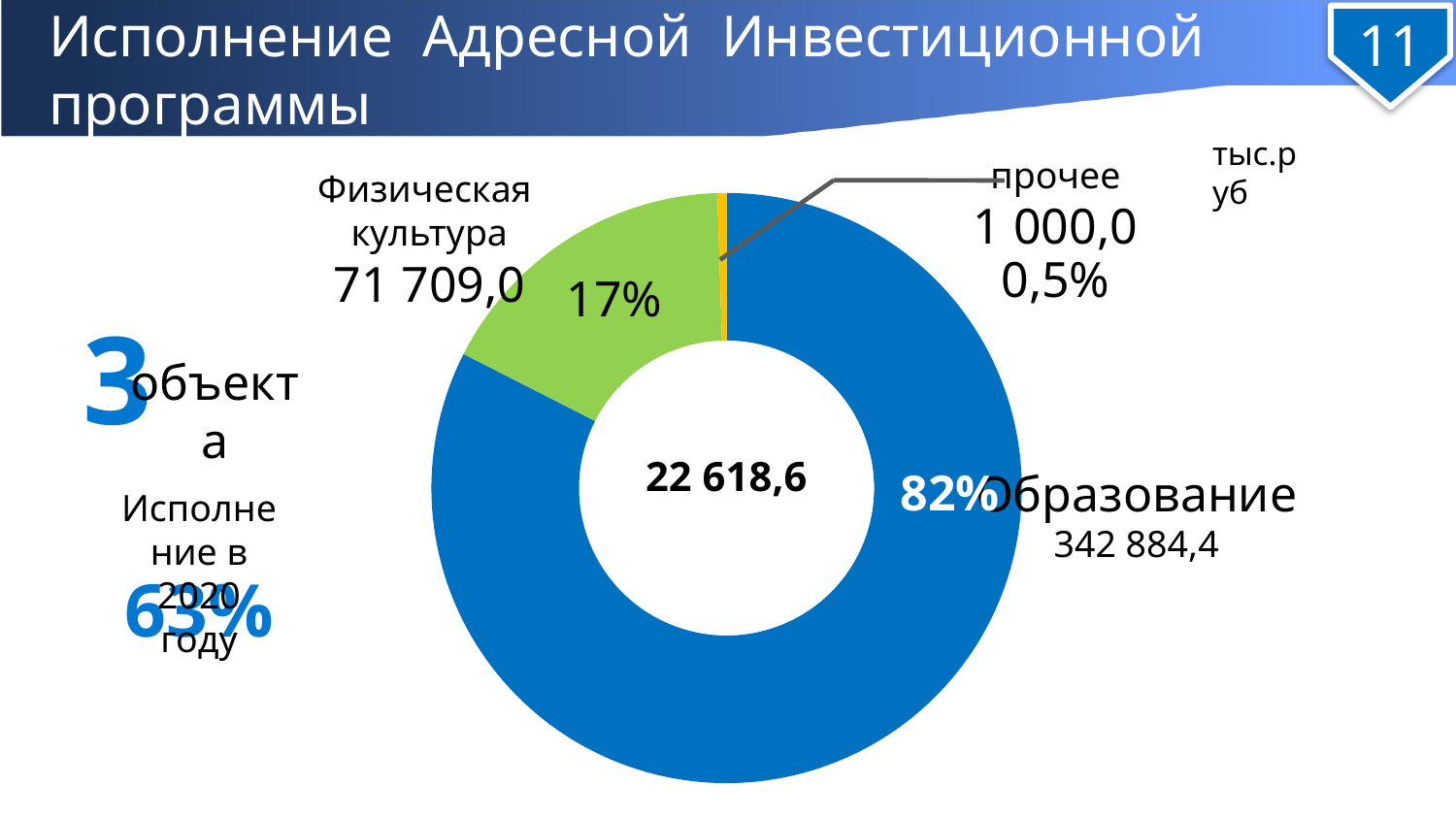
Which is larger, the value for Физическая культура or the value for прочее? Физическая культура What is the value shown for прочее? 1 000,0 What kind of chart is shown on the slide? Doughnut (pie) chart What is the value shown for Образование? 342 884,4 What share of the doughnut does Физическая культура represent? 17% Which category has the largest slice in the doughnut chart? Образование What is the value shown for Физическая культура? 71 709,0 How many slices does the doughnut chart have? 3 Which category has the smallest slice in the doughnut chart? прочее What share of the doughnut does Образование represent? 82% What number is printed in the centre of the doughnut chart? 22 618,6 What share of the doughnut does прочее represent? 0,5%